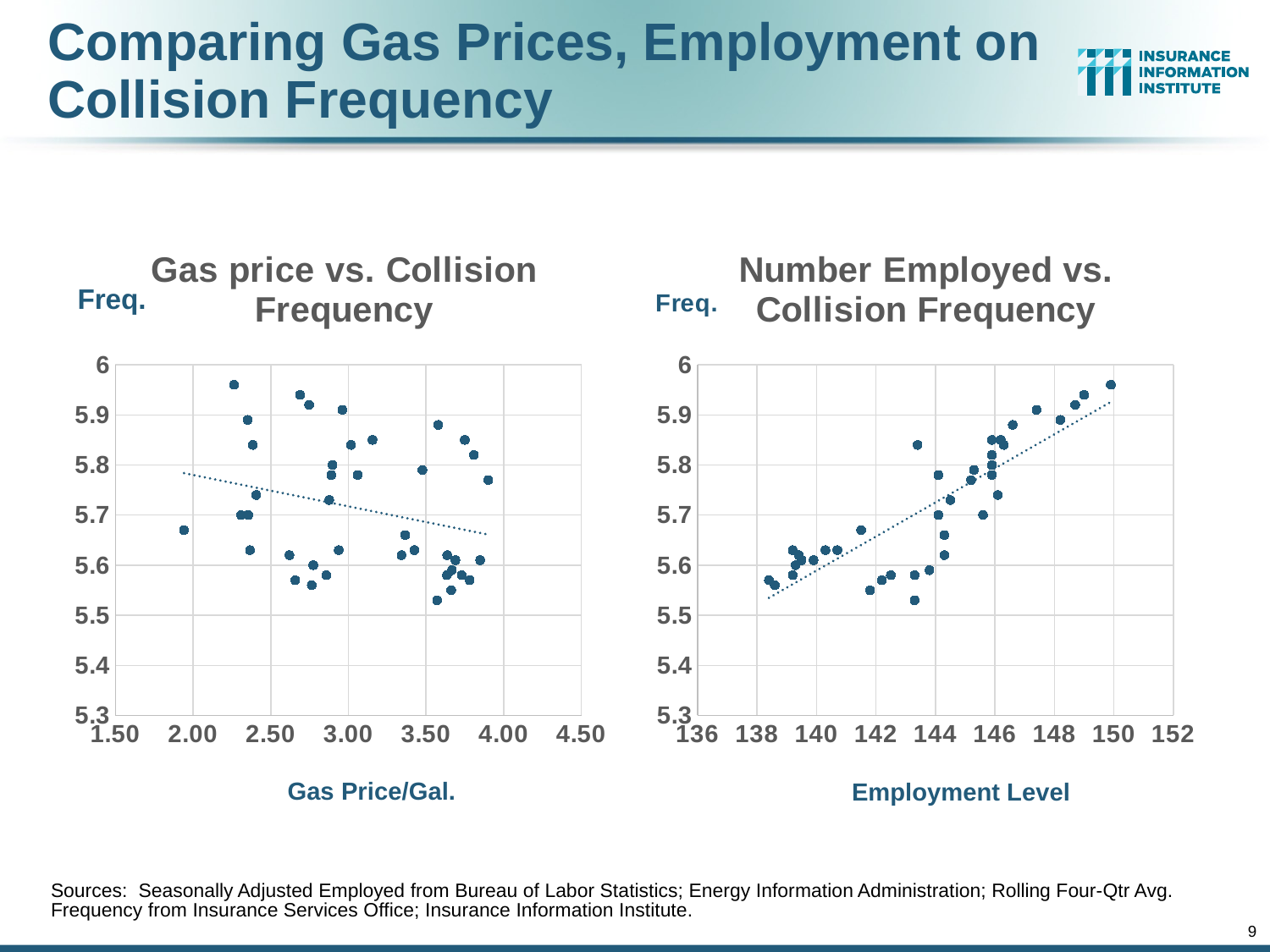
In the right chart "Number Employed vs. Collision Frequency", is the frequency of the point at employment level 150 greater or less than 5.9? greater What is the x-axis label of the left chart "Gas price vs. Collision Frequency"? Gas Price/Gal. In the left chart "Gas price vs. Collision Frequency", does the dotted trend line rise or fall as gas price increases? Fall What kind of chart is the right chart titled "Number Employed vs. Collision Frequency"? Scatter chart In the left chart "Gas price vs. Collision Frequency", is the frequency of the point at a gas price of about 1.93 greater or less than 5.6? greater What is the x-axis label of the right chart "Number Employed vs. Collision Frequency"? Employment Level In the right chart "Number Employed vs. Collision Frequency", is the highest frequency plotted greater or less than 5.9? greater What kind of chart is the left chart titled "Gas price vs. Collision Frequency"? Scatter chart In the right chart "Number Employed vs. Collision Frequency", does the dotted trend line rise or fall as employment level increases? Rise